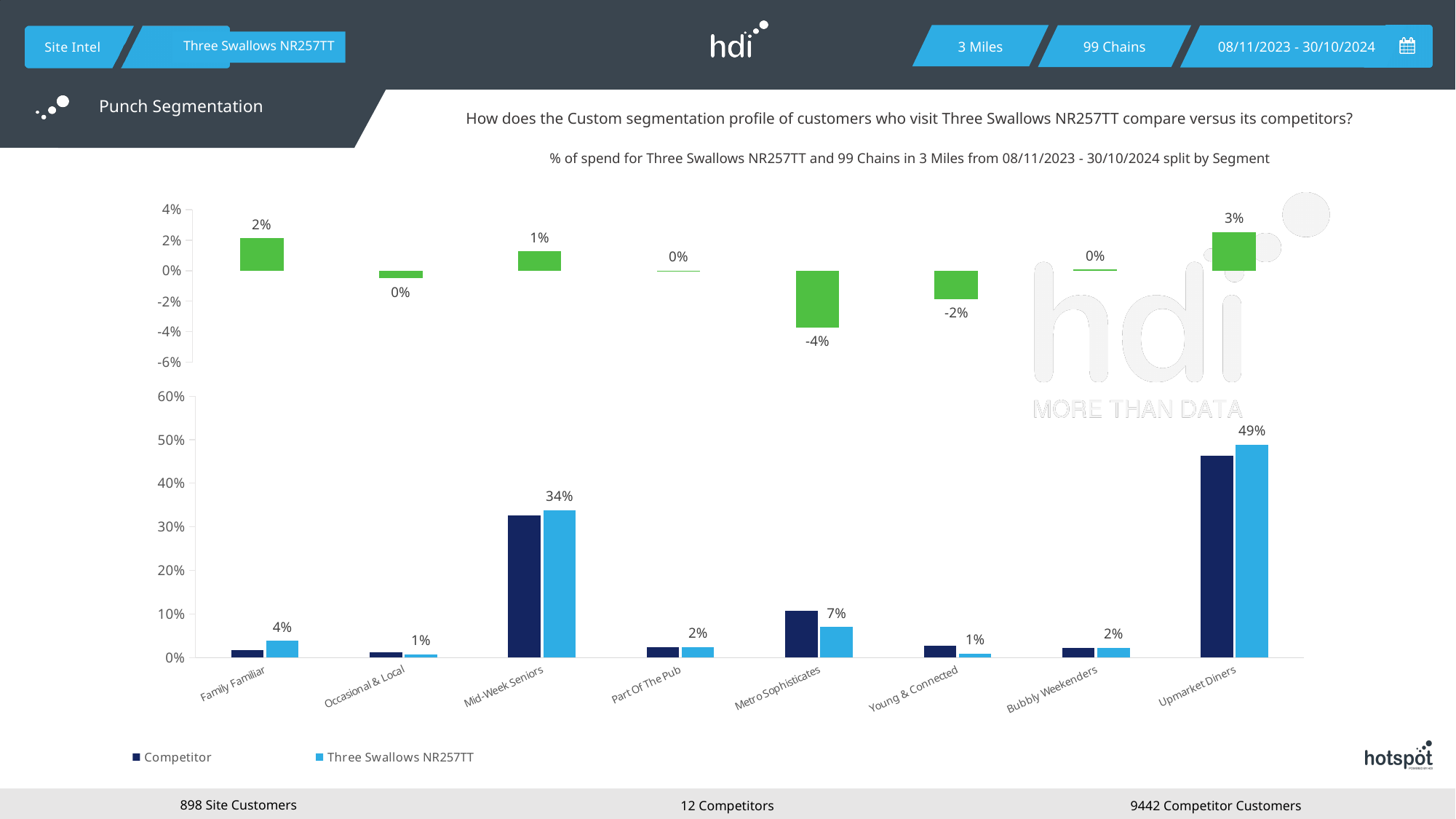
In the top chart, what is the value shown for Upmarket Diners? 3% In the bottom chart, is the Competitor value for Upmarket Diners greater or less than 40%? greater In the bottom chart, what is the value for Three Swallows NR257TT in the Upmarket Diners segment? 49% How many series does the legend of the bottom chart list? 2 In the top chart, which segment has the highest value? Upmarket Diners In the top chart, which segment has the lowest value? Metro Sophisticates In the bottom chart, which segment has the highest value for Three Swallows NR257TT? Upmarket Diners How many segments are shown on the x axis of the bottom chart? 8 In the bottom chart, what is the difference between the Three Swallows NR257TT values for Upmarket Diners and Mid-Week Seniors? 15% In the bottom chart, what is the value for Three Swallows NR257TT in the Mid-Week Seniors segment? 34% In the top chart, what is the value shown for Metro Sophisticates? -4% In the bottom chart, what is the value for Three Swallows NR257TT in the Metro Sophisticates segment? 7%